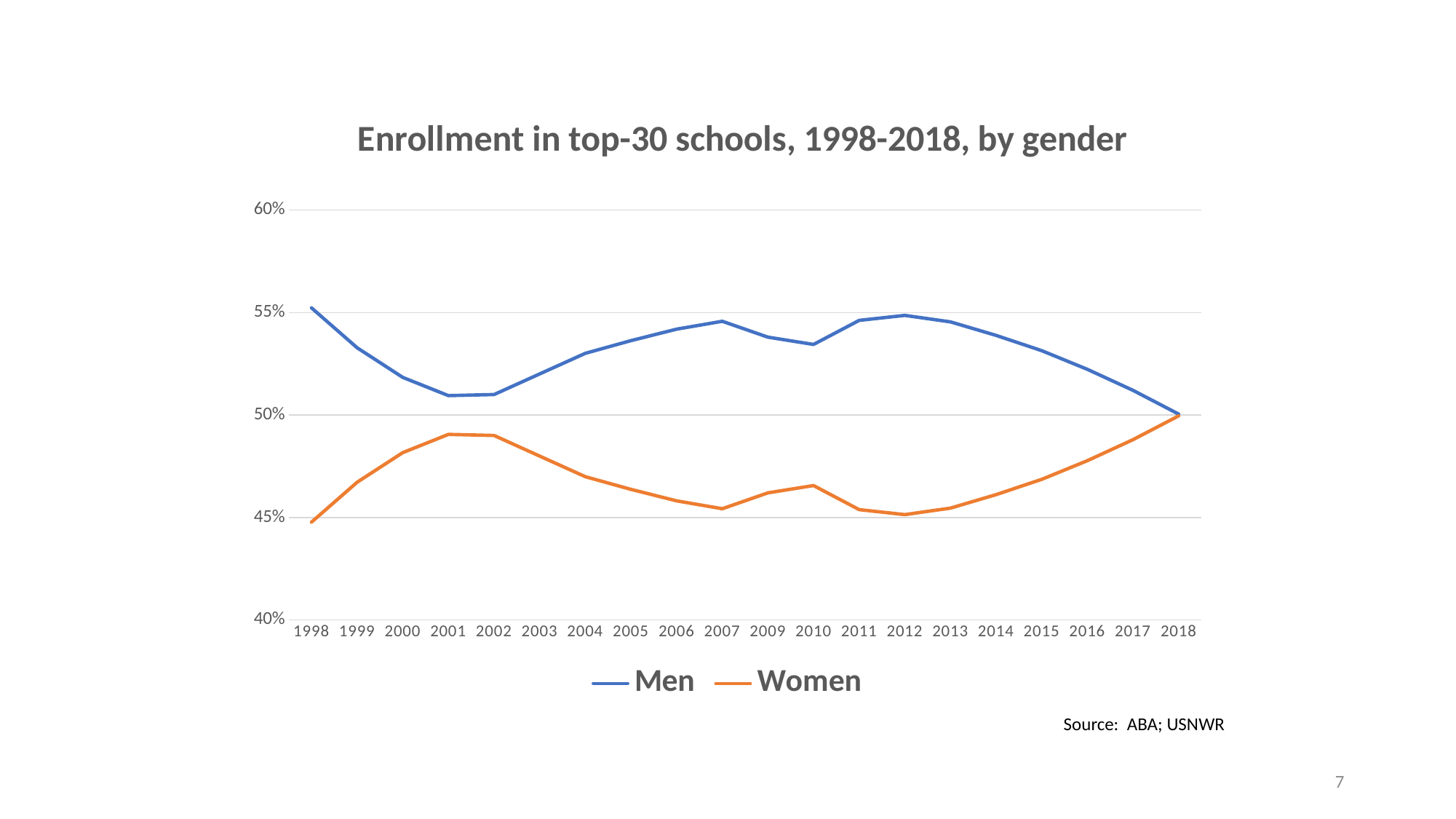
In which year is the Women series at its highest? 2018 Is the value for Men in 2007 greater or less than 55%? less What kind of chart is shown on the slide? line chart How many years are plotted along the x axis? 20 In which year is the Men series at its lowest? 2018 Is the value for Women in 2010 greater or less than 45%? greater What is the title of the chart? Enrollment in top-30 schools, 1998-2018, by gender Does the Women series rise or fall from 2012 to 2018? rise How many series does the legend list? 2 Which series has the larger value in 2010, Men or Women? Men